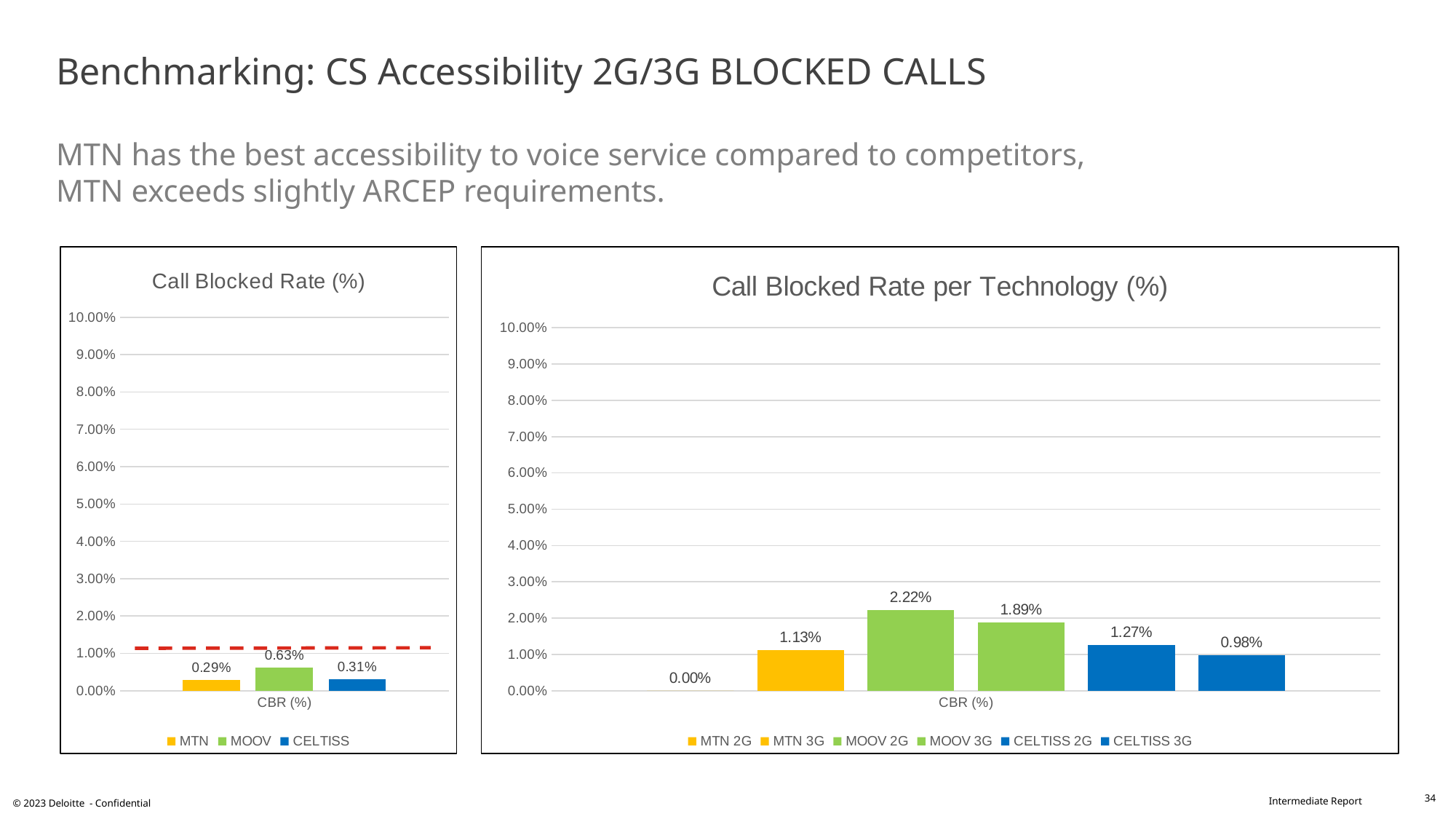
In the 'Call Blocked Rate per Technology (%)' chart, what is the value for CELTISS 3G? 0.98% In the 'Call Blocked Rate (%)' chart, how many series does the legend list? 3 In the 'Call Blocked Rate per Technology (%)' chart, what is the value for MOOV 2G? 2.22% In the 'Call Blocked Rate per Technology (%)' chart, what is the difference between MOOV 2G and MOOV 3G? 0.33% In the 'Call Blocked Rate per Technology (%)' chart, which series has the highest value? MOOV 2G In the 'Call Blocked Rate per Technology (%)' chart, how many series does the legend list? 6 What kind of chart is the 'Call Blocked Rate per Technology (%)' chart? Bar chart In the 'Call Blocked Rate per Technology (%)' chart, which series has the lowest value? MTN 2G In the 'Call Blocked Rate (%)' chart, what is the value for MTN? 0.29% In the 'Call Blocked Rate (%)' chart, what is the value for MOOV? 0.63% In the 'Call Blocked Rate per Technology (%)' chart, which is larger, MTN 3G or CELTISS 2G? CELTISS 2G In the 'Call Blocked Rate (%)' chart, which operator has the highest call blocked rate? MOOV